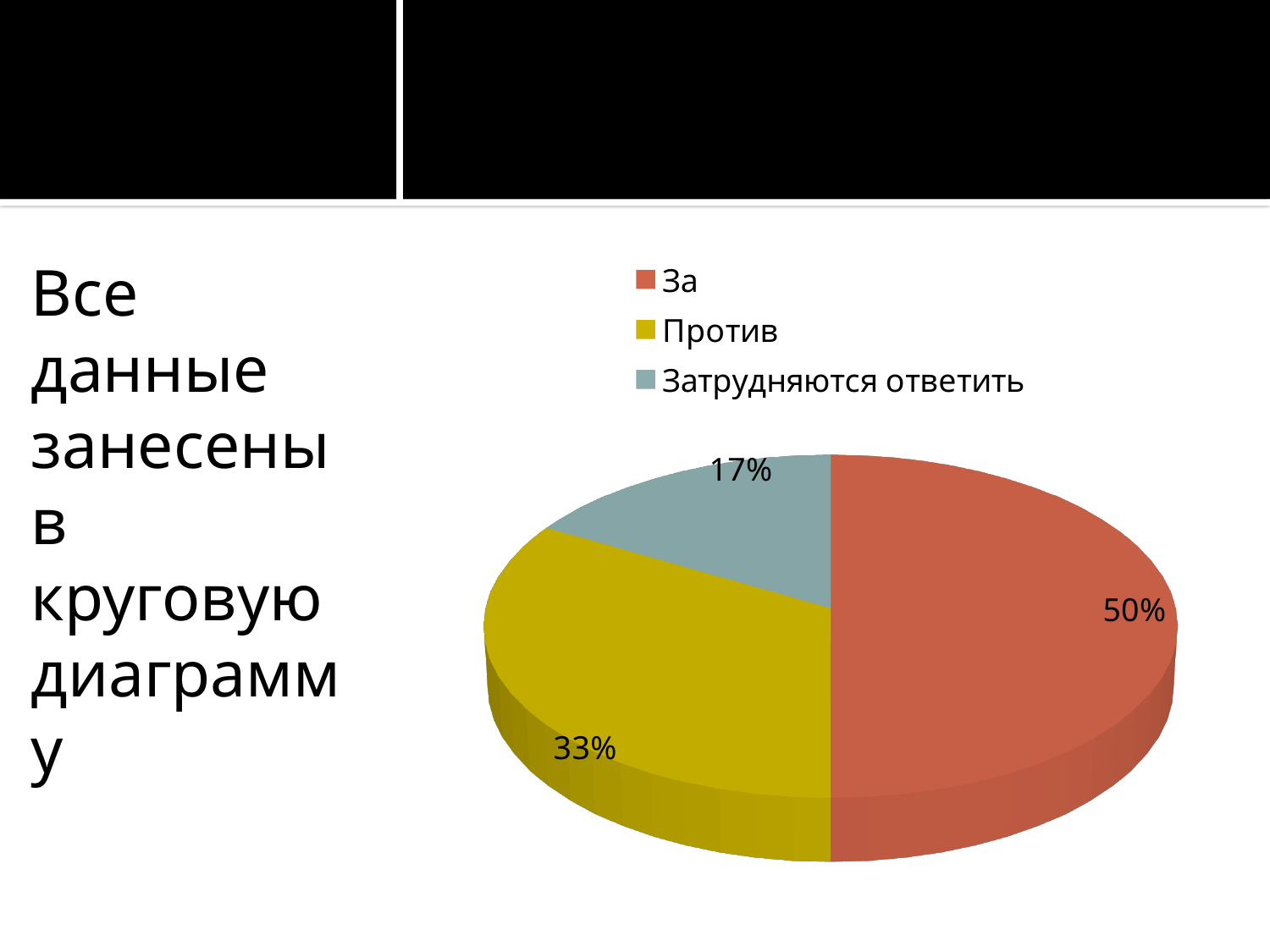
What share of the pie does the "Затрудняются ответить" slice represent? 17% What colour is the "За" slice in the pie chart? red Which category has the largest slice of the pie? За What share of the pie does the "За" slice represent? 50% What kind of chart is shown on the slide? pie chart What is the difference in percentage points between the "За" and "Против" slices? 17% How many categories does the pie chart have? 3 Which category has the smallest slice of the pie? Затрудняются ответить What share of the pie does the "Против" slice represent? 33% What is the difference in percentage points between the "Против" and "Затрудняются ответить" slices? 16% Which slice is larger, "Против" or "Затрудняются ответить"? Против How many entries does the legend list? 3